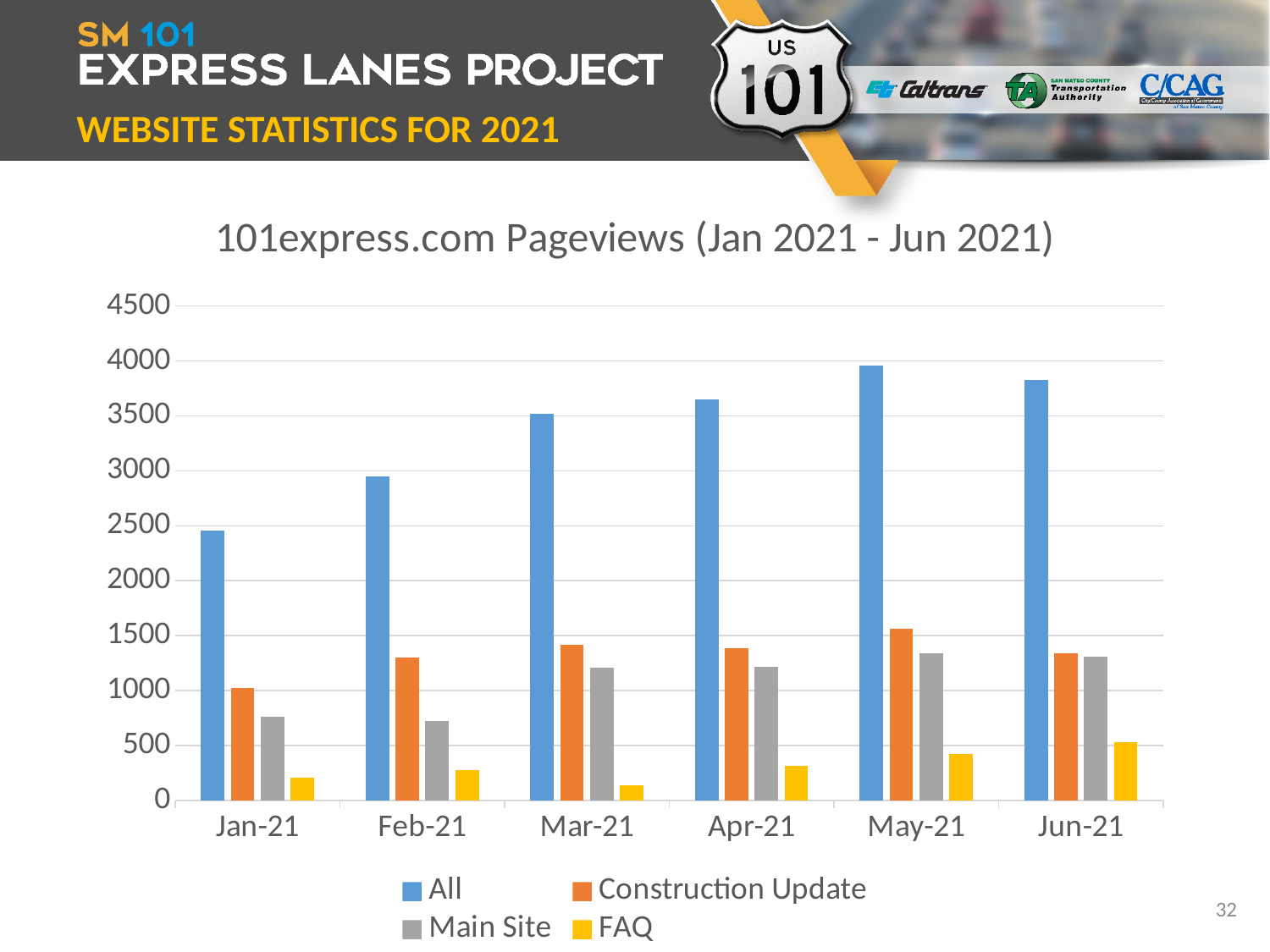
In which month is the FAQ series lowest? Mar-21 Does the All series rise or fall from Jan-21 to May-21? Rise In which month is the FAQ series highest? Jun-21 How many series does the legend list? 4 Is the value for Main Site in Jan-21 greater or less than 1000? less In which month is the All series highest? May-21 How many months are shown on the x axis? 6 Which is larger in Jan-21, Construction Update or Main Site? Construction Update What kind of chart is shown on the slide? Bar chart In which month is the All series lowest? Jan-21 Is the value for All in Apr-21 greater or less than 3500? greater What is the title of the chart? 101express.com Pageviews (Jan 2021 - Jun 2021)